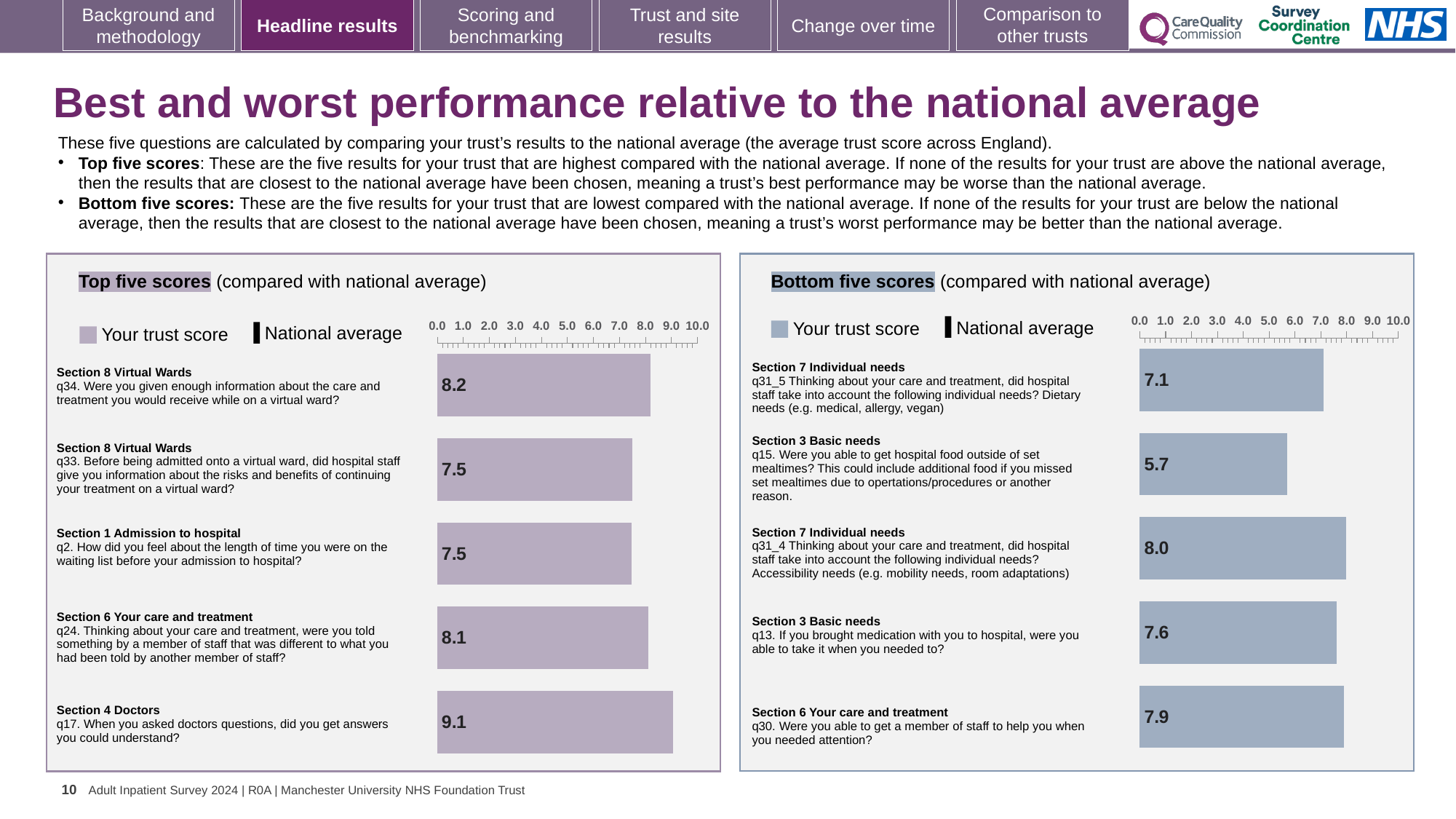
In the Bottom five scores chart, is the trust score for q15 greater or less than 6.0? less In the Bottom five scores chart, which has the larger trust score: q31_4 or q13? q31_4 In the Bottom five scores chart, what is the trust score for q15 (Were you able to get hospital food outside of set mealtimes?)? 5.7 In the Bottom five scores chart, which question has the highest trust score? q31_4 (Section 7 Individual needs) In the Top five scores chart, which question has the highest trust score? q17 (Section 4 Doctors) In the Bottom five scores chart, what is the difference between the trust scores for q30 and q31_5? 0.8 In the Top five scores chart, what is the trust score for q24 (were you told something by a member of staff that was different to what you had been told by another member of staff?)? 8.1 In the Top five scores chart, what is the difference between the trust scores for q17 and q34? 0.9 In the Bottom five scores chart, which question has the lowest trust score? q15 (Section 3 Basic needs) In the Top five scores chart, what is the trust score for q17 (When you asked doctors questions, did you get answers you could understand?)? 9.1 How many bars are shown in the Top five scores chart? 5 What kind of chart is the Bottom five scores chart? bar chart